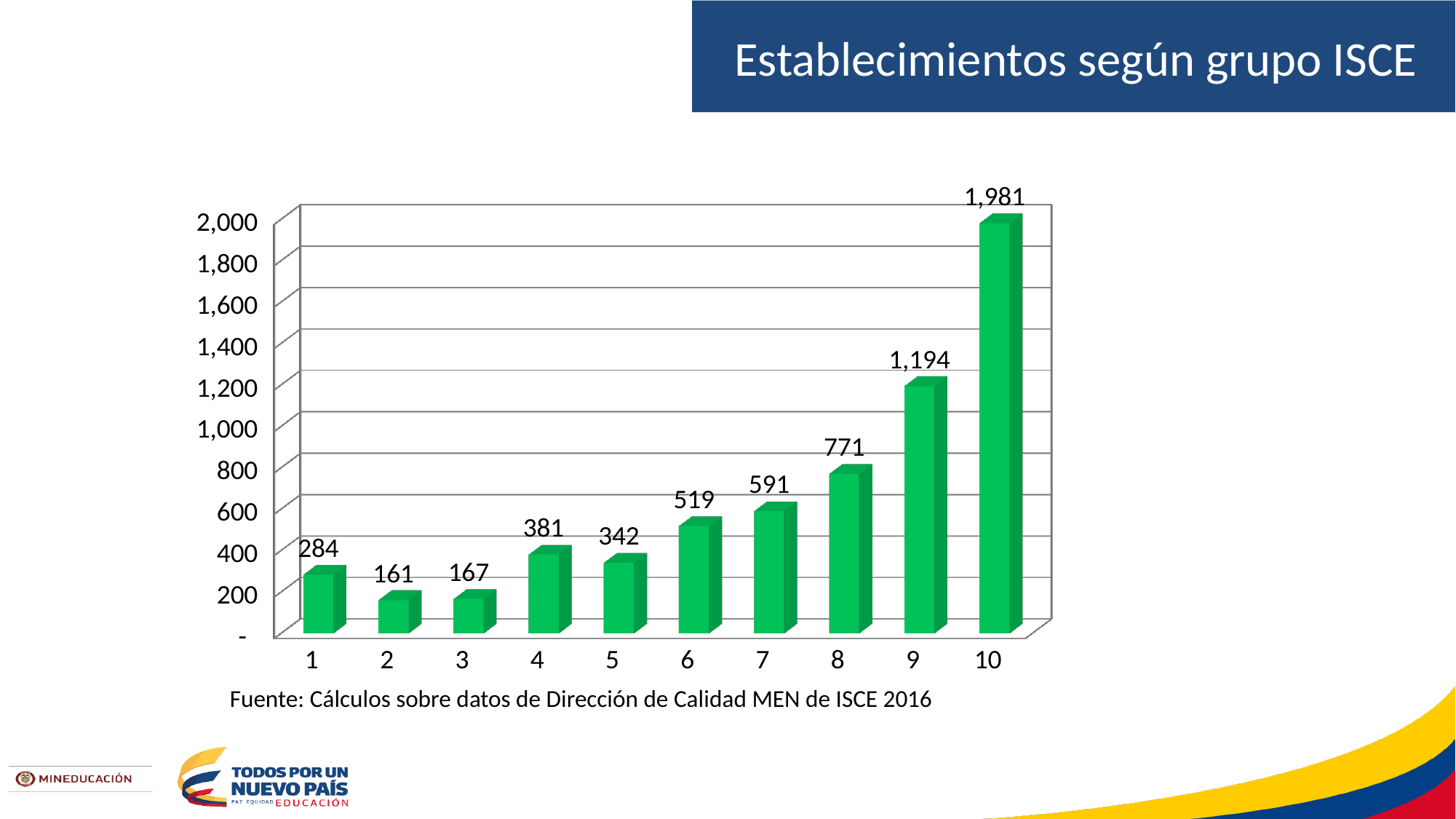
Which group has the lowest value? 2 Which is larger, the value for group 4 or the value for group 5? group 4 What is the value for group 4? 381 Which group has the highest value? 10 How many groups are shown on the x axis? 10 Is the value for group 8 greater or less than 600? greater What is the value for group 7? 591 What is the title of the slide? Establecimientos según grupo ISCE What is the value for group 10? 1,981 What is the difference between the values for group 9 and group 8? 423 What is the difference between the values for group 1 and group 2? 123 What kind of chart is shown on the slide? bar chart